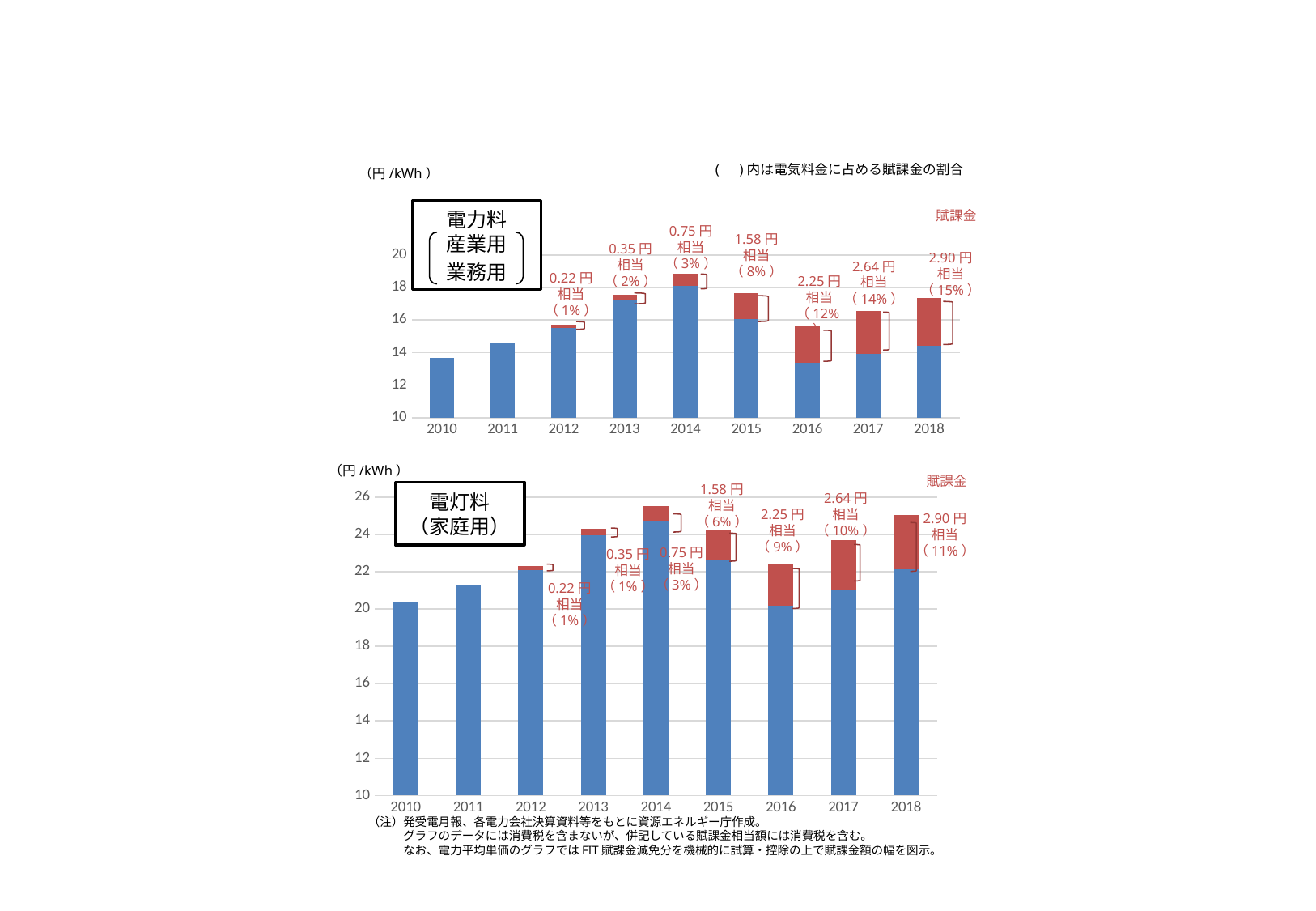
In the bottom chart (電灯料 家庭用), is the total value for 2014 greater or less than 24? greater What kind of chart is the top chart (電力料 産業用・業務用)? Stacked bar chart How many years are shown on the x axis of the bottom chart (電灯料 家庭用)? 9 In the top chart (電力料 産業用・業務用), what is the surcharge (賦課金) amount shown for 2018? 2.90円相当 In the top chart (電力料 産業用・業務用), how much larger is the surcharge amount in 2018 than in 2012? 2.68円 Which is larger: the 2018 surcharge share in the top chart (電力料) or in the bottom chart (電灯料)? Top chart (電力料), 15% In the bottom chart (電灯料 家庭用), what share of the electricity price does the surcharge account for in 2018? 11% In the top chart (電力料 産業用・業務用), is the value for 2010 greater or less than 14? less In the top chart (電力料 産業用・業務用), what share of the electricity price does the surcharge account for in 2016? 12% In the top chart (電力料 産業用・業務用), which year has the tallest total bar? 2014 In the bottom chart (電灯料 家庭用), which year has the shortest bar? 2010 In the bottom chart (電灯料 家庭用), what is the surcharge amount shown for 2015? 1.58円相当